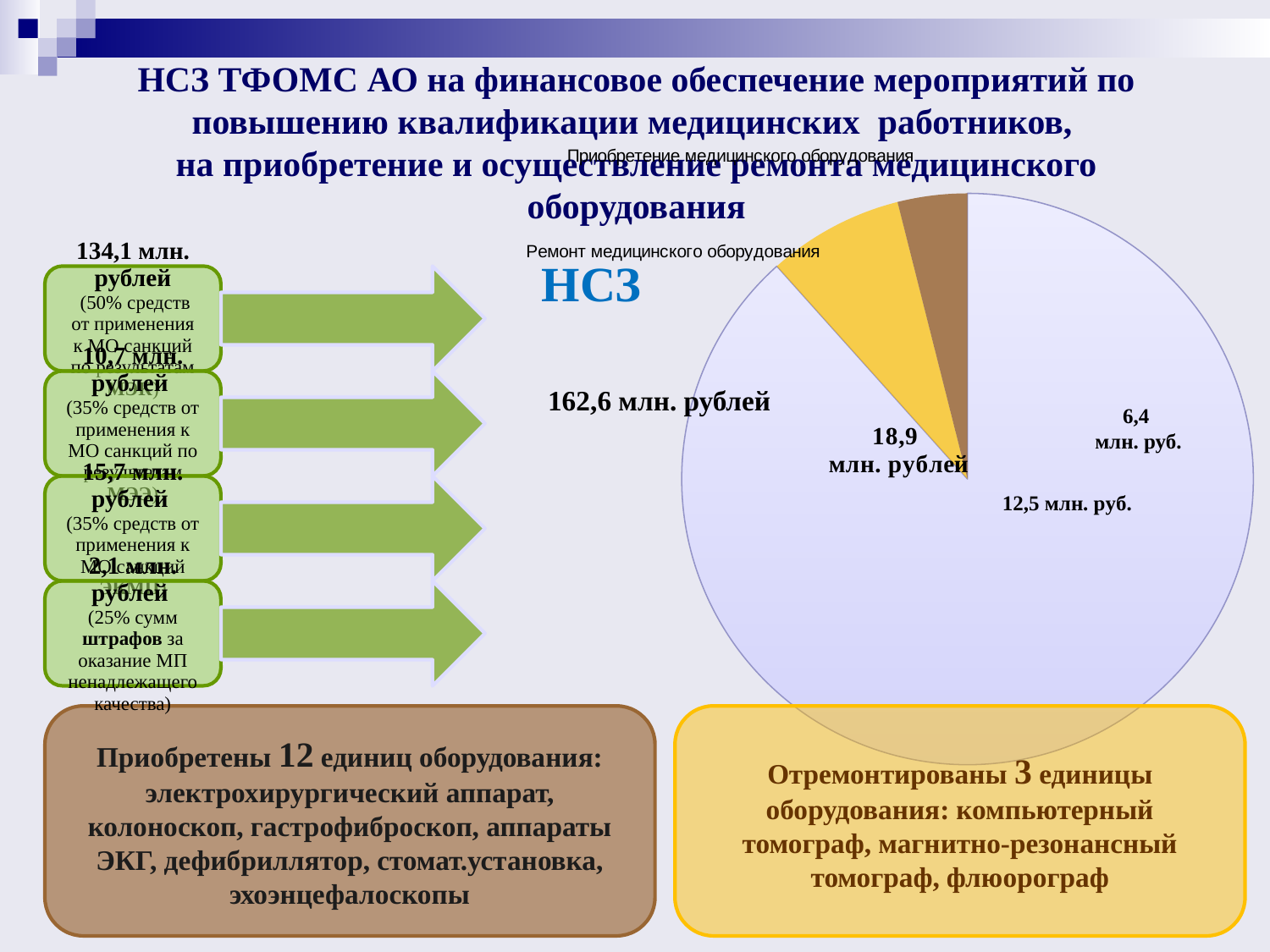
What colour is the slice labelled 18,9 млн. рублей? Yellow How many slices does the pie chart have? 3 What kind of chart is shown on the right side of the slide? Pie chart What value is labelled next to the yellow slice of the pie chart? 18,9 млн. рублей Which slice of the pie chart is the smallest? The brown slice What colour is the largest slice of the pie chart? Light blue (lavender) Which is larger on the pie chart: 162,6 млн. рублей or 18,9 млн. рублей? 162,6 млн. рублей What value is shown for НСЗ on the pie chart? 162,6 млн. рублей Which slice of the pie chart is the largest? The large light blue (lavender) slice Does the НСЗ slice take up more or less than half of the pie chart? More